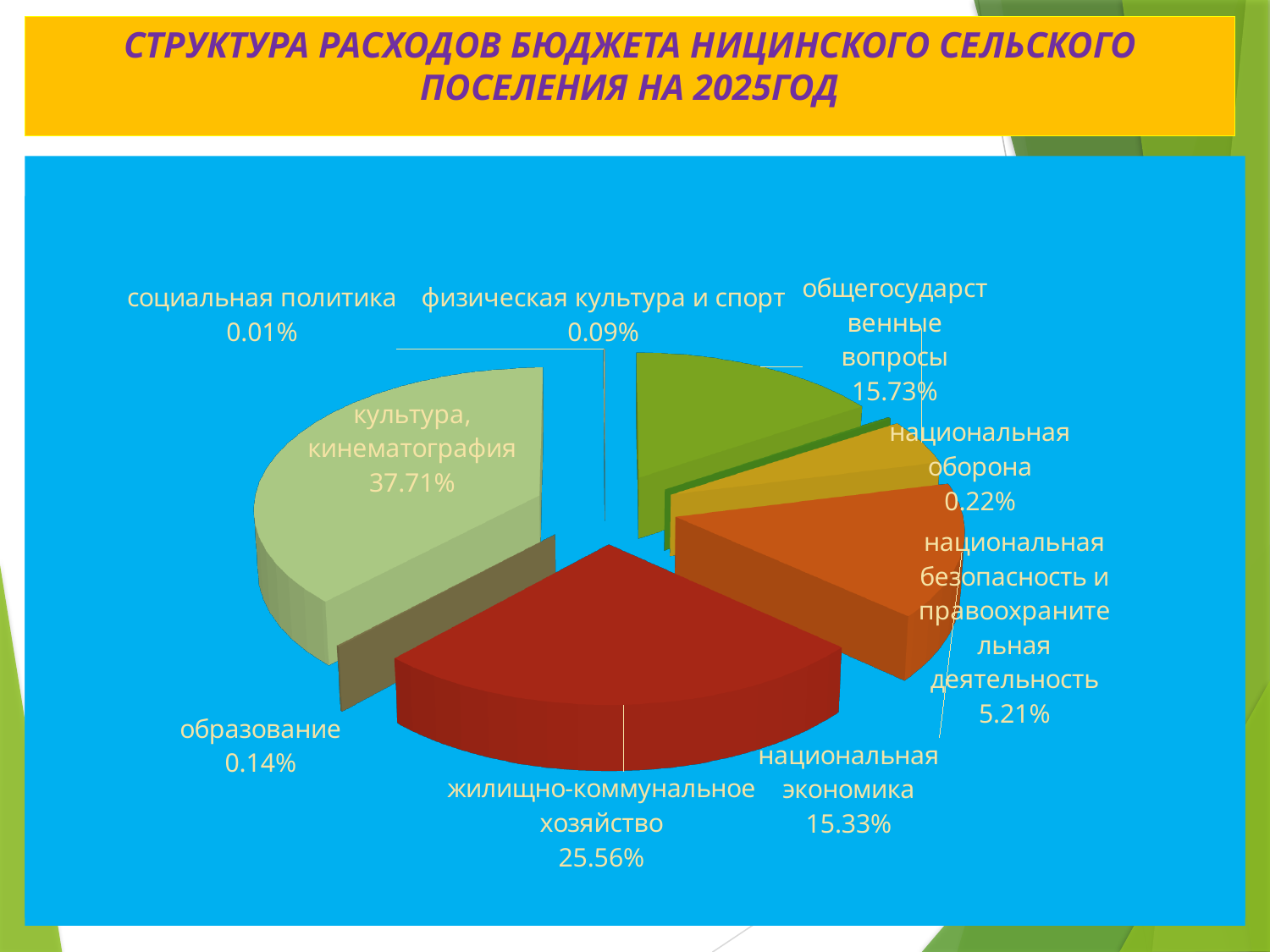
Which category has the largest share of the pie? культура, кинематография What is the value shown for жилищно-коммунальное хозяйство? 25.56% Which is larger: the share for общегосударственные вопросы or the share for национальная экономика? общегосударственные вопросы What share is shown for национальная безопасность и правоохранительная деятельность? 5.21% What percentage is shown for национальная экономика? 15.33% What is the difference between the shares of культура, кинематография and жилищно-коммунальное хозяйство? 12.15% Which category has the smallest share of the pie? социальная политика What is the value for общегосударственные вопросы? 15.73% What share of the budget expenditure goes to культура, кинематография? 37.71% What is the title of the slide containing the chart? СТРУКТУРА РАСХОДОВ БЮДЖЕТА НИЦИНСКОГО СЕЛЬСКОГО ПОСЕЛЕНИЯ НА 2025ГОД How many categories are shown in the pie chart? 9 What type of chart is shown on the slide? pie chart